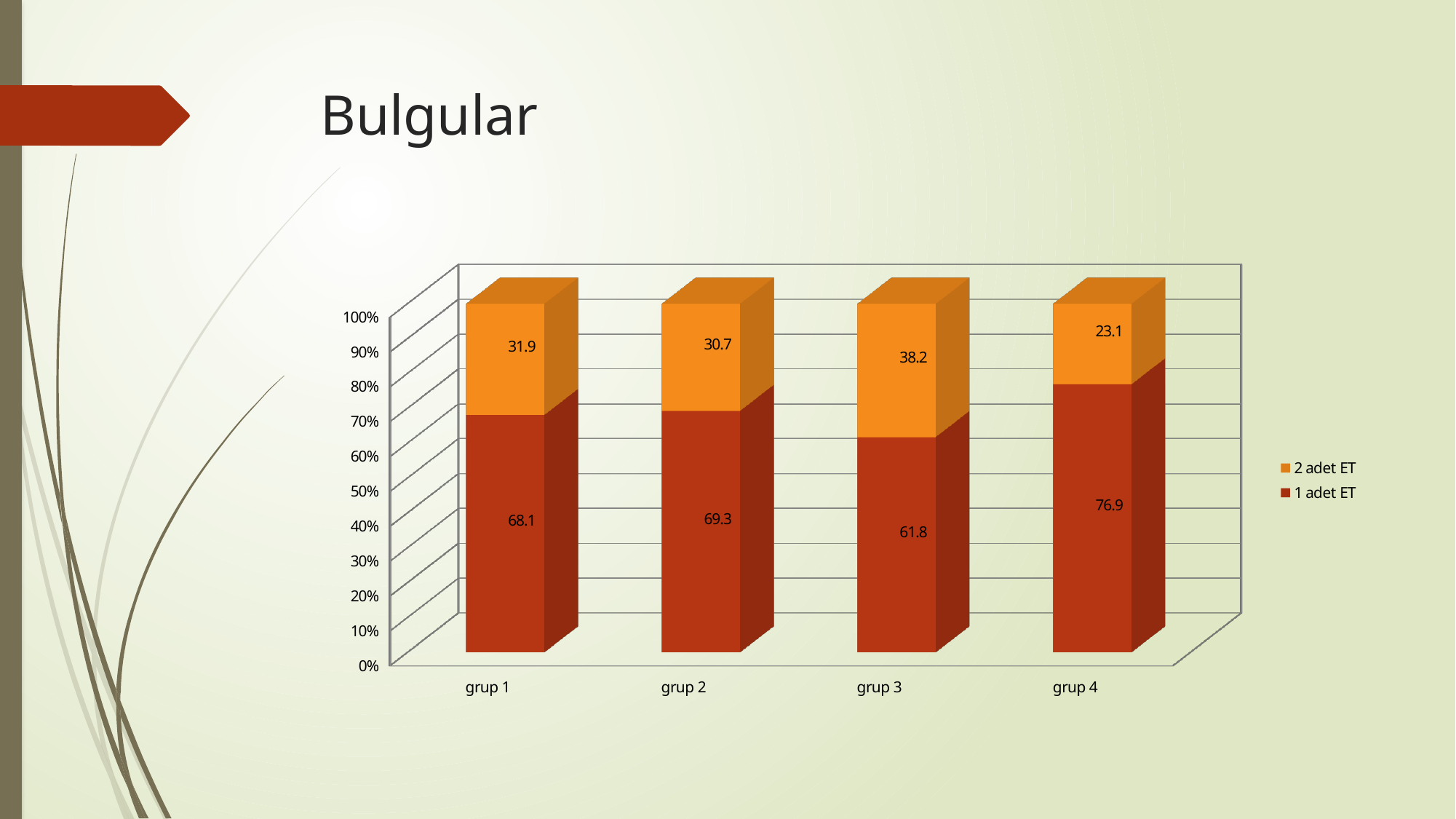
What is the value for "2 adet ET" in grup 3? 38.2 Which group has the highest value for "1 adet ET"? grup 4 Which is larger: the "2 adet ET" value for grup 1 or for grup 2? grup 1 What is the value for "1 adet ET" in grup 1? 68.1 What kind of chart is shown on the slide? stacked bar chart What is the value for "2 adet ET" in grup 2? 30.7 What is the value for "1 adet ET" in grup 4? 76.9 What is the title of the slide containing the chart? Bulgular How many series does the legend list? 2 Which group has the lowest value for "2 adet ET"? grup 4 What is the difference between the "1 adet ET" values for grup 4 and grup 3? 15.1 How many groups are shown on the x axis? 4